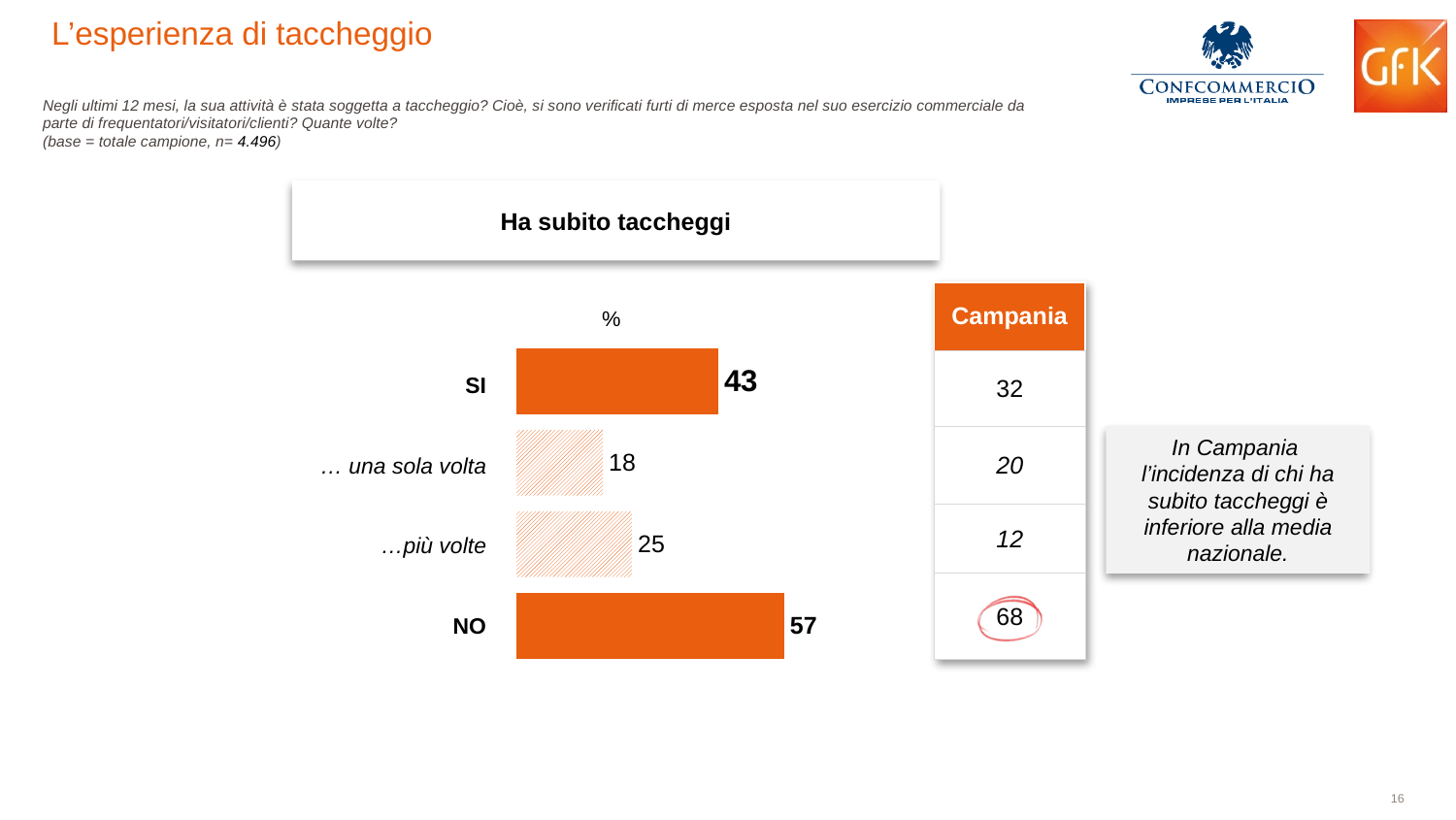
How many bars are shown in the 'Ha subito taccheggi' chart? 4 What is the title of the chart on the slide? Ha subito taccheggi What is the value for NO in the 'Ha subito taccheggi' chart? 57 What is the value for SI in the 'Ha subito taccheggi' chart? 43 Which category has the lowest value in the 'Ha subito taccheggi' chart? … una sola volta What is the difference between the values for '…più volte' and '… una sola volta' in the 'Ha subito taccheggi' chart? 7 What kind of chart is 'Ha subito taccheggi'? Bar chart What is the value for '…più volte' in the 'Ha subito taccheggi' chart? 25 Which is larger in the 'Ha subito taccheggi' chart, the value for '…più volte' or for '… una sola volta'? …più volte What is the value for '… una sola volta' in the 'Ha subito taccheggi' chart? 18 Which category has the highest value in the 'Ha subito taccheggi' chart? NO What is the difference between the values for NO and SI in the 'Ha subito taccheggi' chart? 14